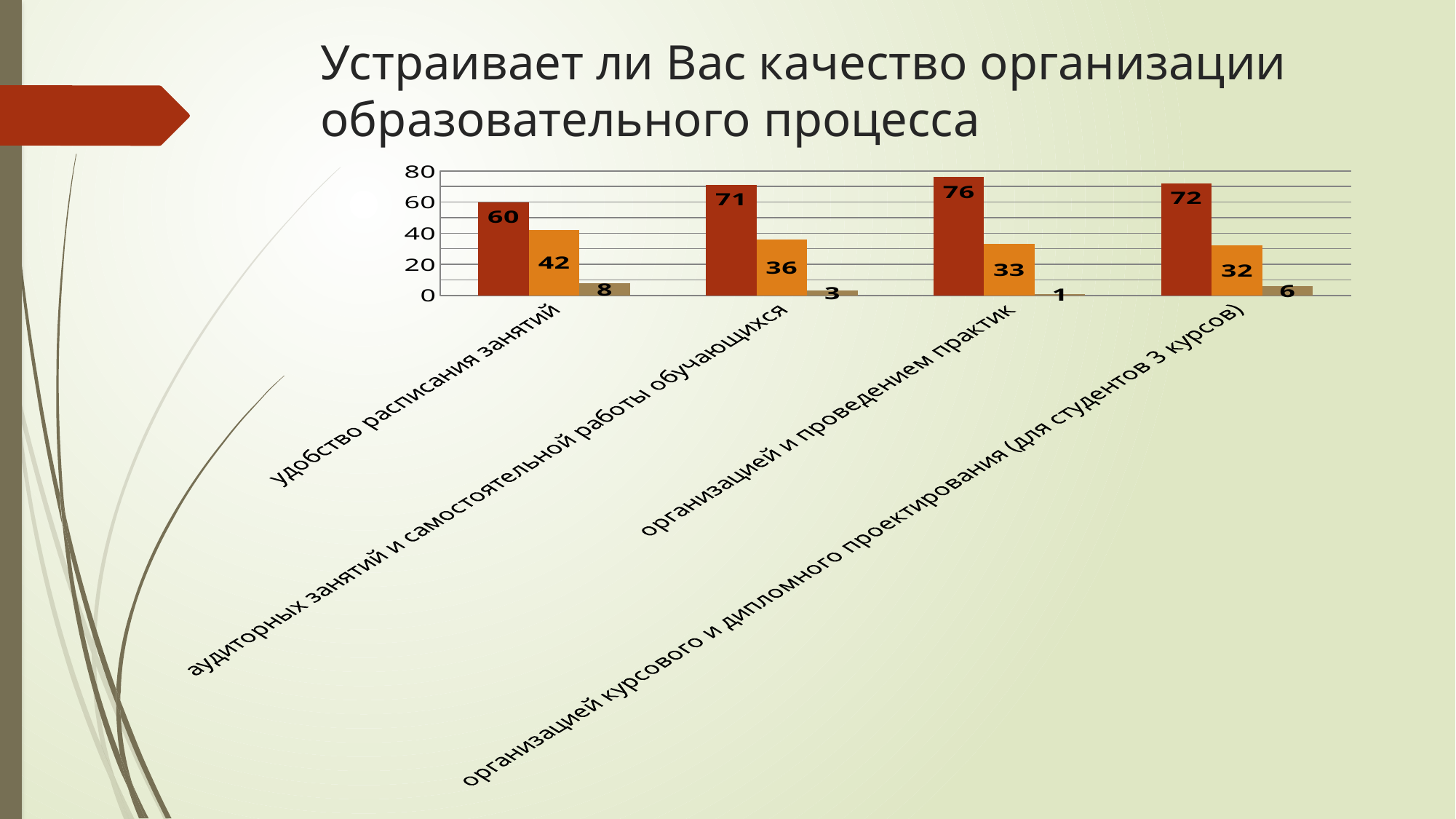
What is the title of the slide containing the chart? Устраивает ли Вас качество организации образовательного процесса What is the value of the orange bar for 'организацией и проведением практик'? 33 How many bars are plotted for each category in the chart? 3 Is the dark red bar for 'аудиторных занятий и самостоятельной работы обучающихся' greater or less than 60? greater What is the value of the dark red bar for 'удобство расписания занятий'? 60 Which is larger: the orange bar for 'удобство расписания занятий' or the orange bar for 'аудиторных занятий и самостоятельной работы обучающихся'? удобство расписания занятий Which category has the lowest tan (third) bar? организацией и проведением практик What kind of chart is shown on the slide? bar chart How many categories are shown on the x axis of the chart? 4 Which category has the highest dark red bar? организацией и проведением практик What is the value of the tan (third) bar for 'аудиторных занятий и самостоятельной работы обучающихся'? 3 What is the difference between the dark red bar and the orange bar for 'организацией курсового и дипломного проектирования (для студентов 3 курсов)'? 40